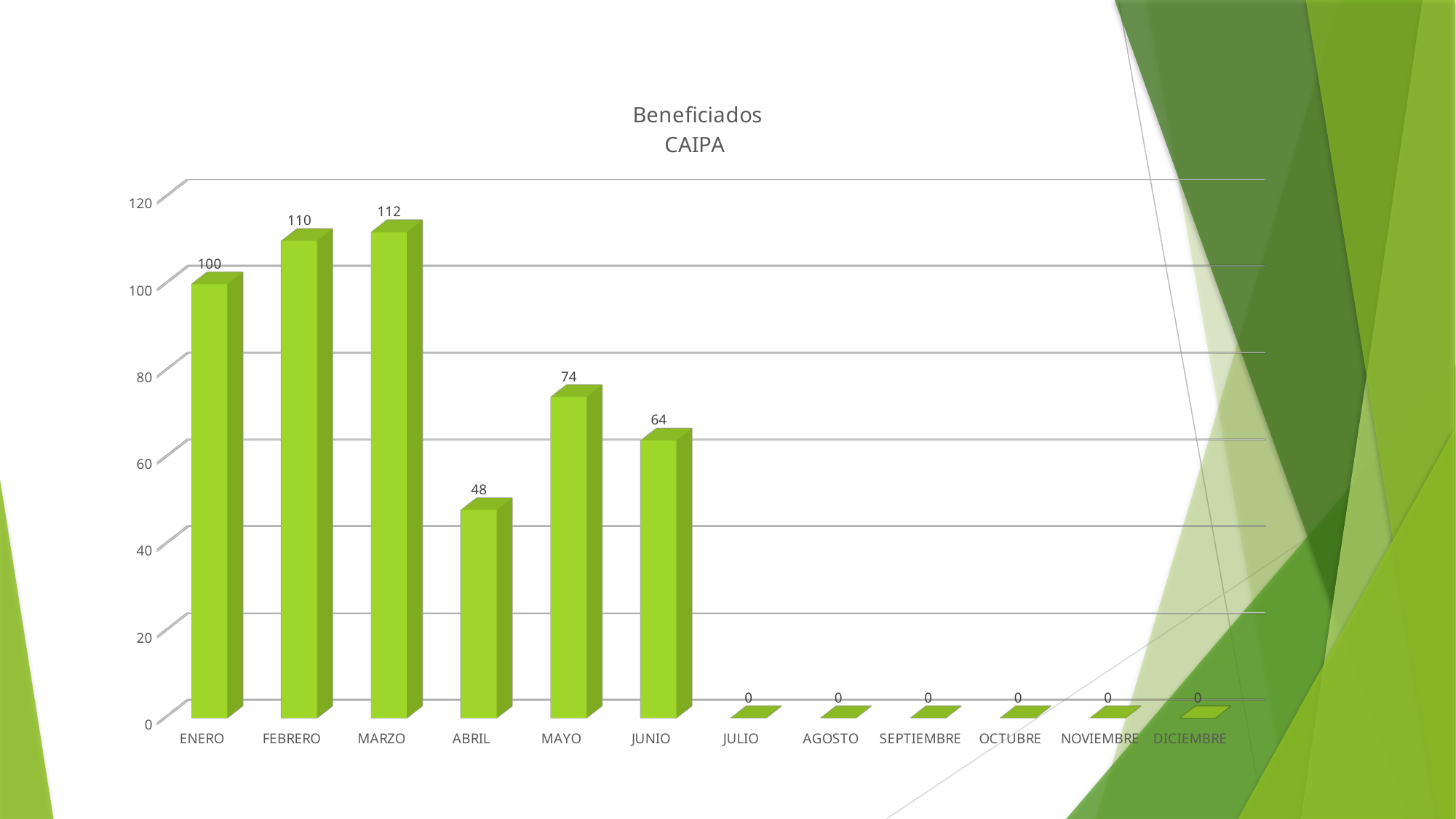
Which is larger, the value for MAYO or the value for JUNIO? MAYO What is the value for ABRIL? 48 What is the value for JUNIO? 64 What is the difference between the values for MAYO and ABRIL? 26 Which month has the highest value? MARZO What is the value for JULIO? 0 Is the value for ABRIL greater or less than 60? less How many months are shown on the x axis? 12 What is the title of the chart? Beneficiados CAIPA What kind of chart is shown? bar chart What is the value for MARZO? 112 What is the difference between the values for FEBRERO and ENERO? 10